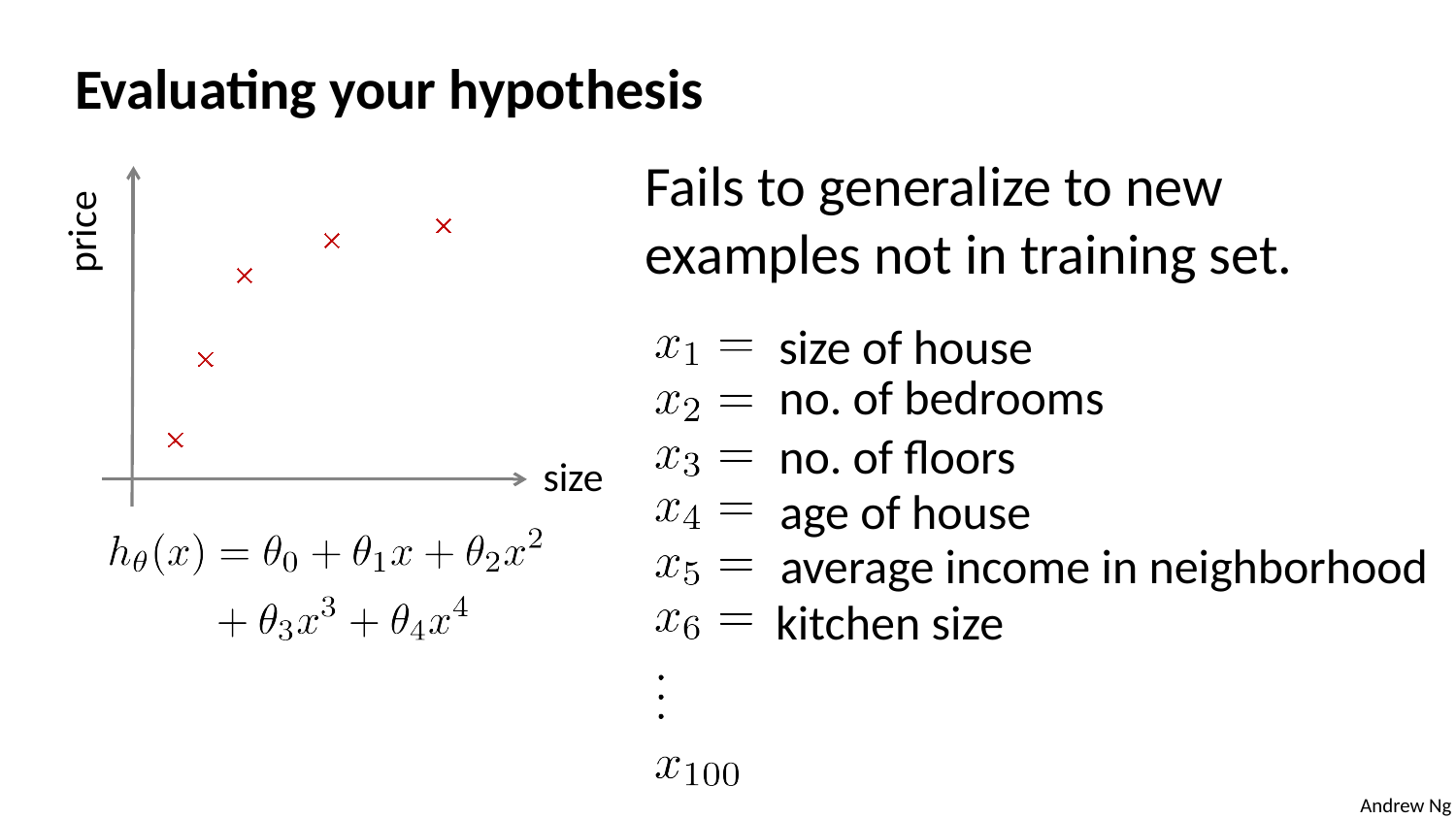
What is the label of the horizontal axis of the chart? size What is the label of the vertical axis of the chart? price What kind of chart is shown on the slide? scatter plot Which plotted point has the highest price: the one with the smallest size or the one with the largest size? the one with the largest size How many data points are plotted on the chart? 5 Is the price of the point with the largest size larger or smaller than the price of the point with the smallest size? larger Do the plotted prices rise or fall as size increases along the x axis? rise Which plotted point has the lowest price: the one with the smallest size or the one with the largest size? the one with the smallest size